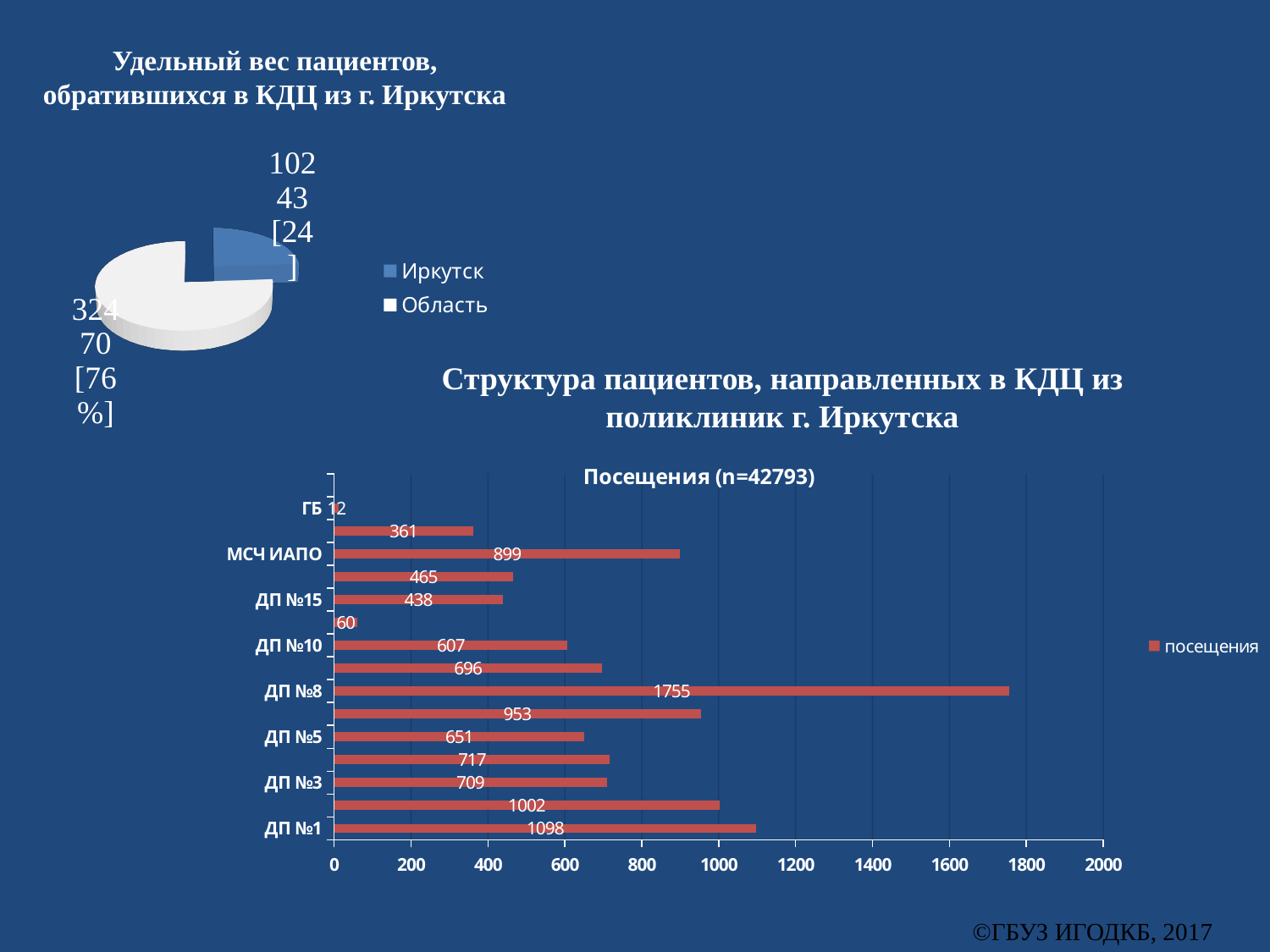
In the bar chart 'Структура пациентов, направленных в КДЦ из поликлиник г. Иркутска', what is the value for ДП №8? 1755 In the bar chart 'Структура пациентов, направленных в КДЦ из поликлиник г. Иркутска', what is the value for ДП №15? 438 In the pie chart 'Удельный вес пациентов, обратившихся в КДЦ из г. Иркутска', what share of the pie does Область have? 76% In the bar chart 'Структура пациентов, направленных в КДЦ из поликлиник г. Иркутска', which is larger, the value for ДП №10 or the value for ДП №5? ДП №5 In the bar chart 'Структура пациентов, направленных в КДЦ из поликлиник г. Иркутска', what is the value for МСЧ ИАПО? 899 In the bar chart 'Структура пациентов, направленных в КДЦ из поликлиник г. Иркутска', how many bars are plotted? 15 In the bar chart 'Структура пациентов, направленных в КДЦ из поликлиник г. Иркутска', which labelled category has the highest value? ДП №8 In the bar chart 'Структура пациентов, направленных в КДЦ из поликлиник г. Иркутска', how many series does the legend list? 1 In the bar chart 'Структура пациентов, направленных в КДЦ из поликлиник г. Иркутска', what is the value for ДП №1? 1098 In the bar chart 'Структура пациентов, направленных в КДЦ из поликлиник г. Иркутска', what is the difference between the values for ДП №8 and ДП №1? 657 What kind of chart is 'Структура пациентов, направленных в КДЦ из поликлиник г. Иркутска'? bar chart In the bar chart 'Структура пациентов, направленных в КДЦ из поликлиник г. Иркутска', which labelled category has the lowest value? ГБ